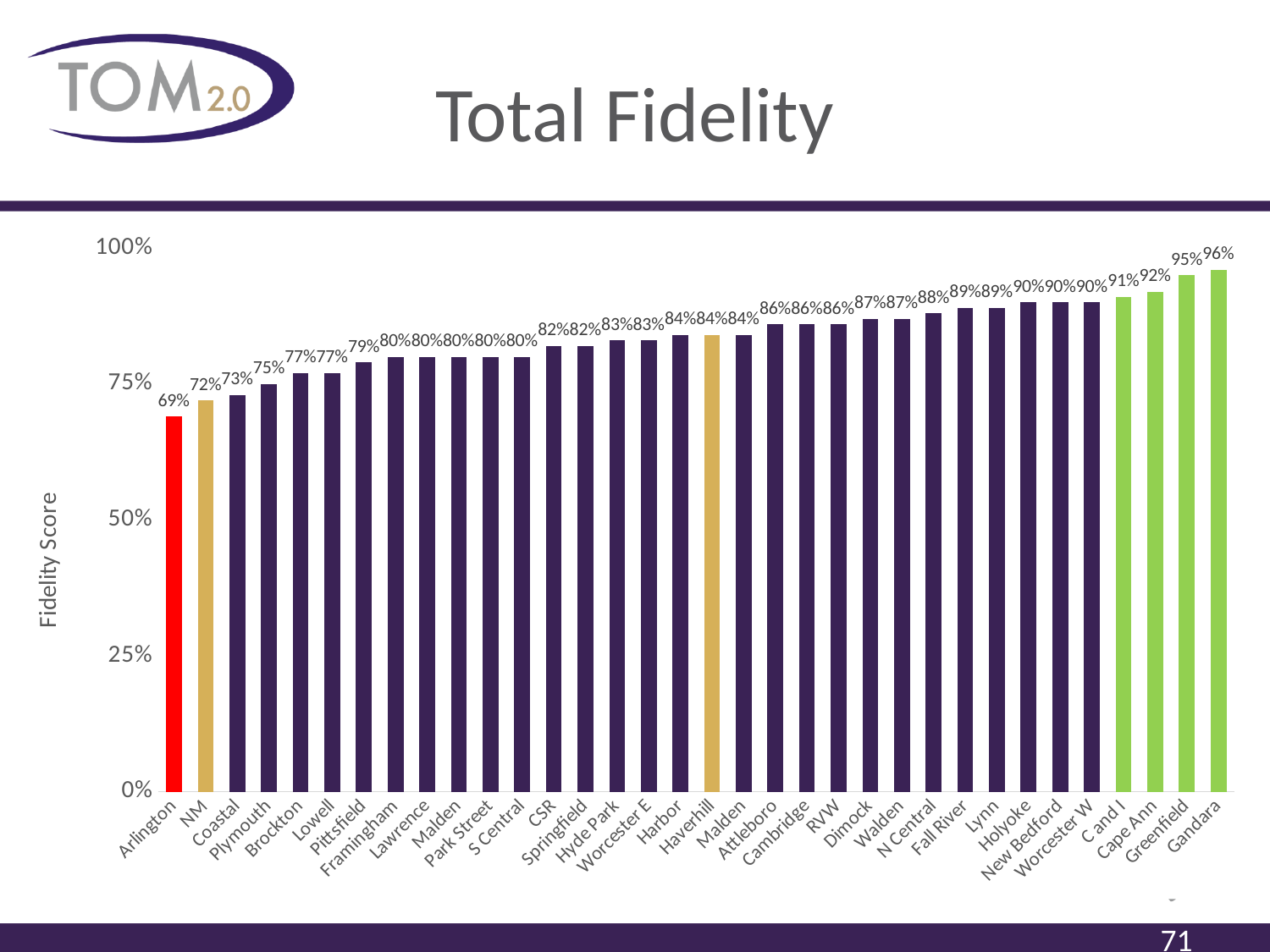
Do the fidelity scores rise or fall from left to right along the x axis? Rise What is the fidelity score for Arlington? 69% Is the value for Arlington greater or less than 75%? less What is the title of the y axis? Fidelity Score Which site has the lowest fidelity score? Arlington What is the fidelity score for Cambridge? 86% What is the fidelity score for Gandara? 96% What is the fidelity score for Pittsfield? 79% What kind of chart is shown on the slide? Bar chart Which site has the highest fidelity score? Gandara Which has a higher fidelity score, Holyoke or Plymouth? Holyoke What is the difference between the fidelity scores of Gandara and Arlington? 27 percentage points